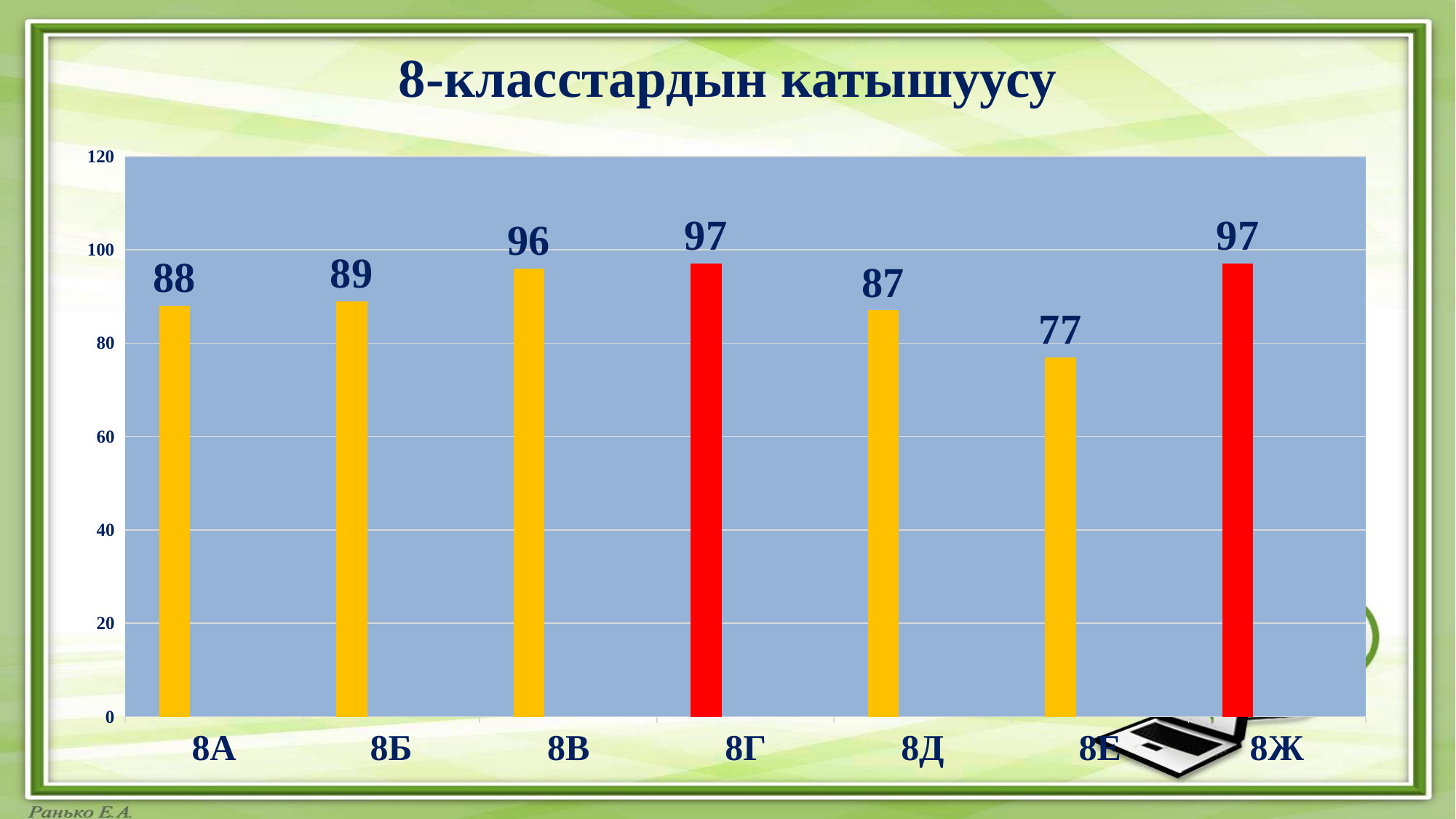
What is the value for 8В? 96 What is the value for 8А? 88 How many categories are shown on the chart? 7 What is the highest value shown on the chart? 97 Which category has the lowest value? 8Е What is the title of the chart? 8-класстардын катышуусу What is the difference between the values for 8Г and 8Е? 20 What is the value for 8Е? 77 Is the value for 8Ж greater or less than 80? greater Which is larger, the value for 8В or the value for 8Д? 8В What kind of chart is shown on the slide? bar chart What is the difference between the values for 8Б and 8А? 1